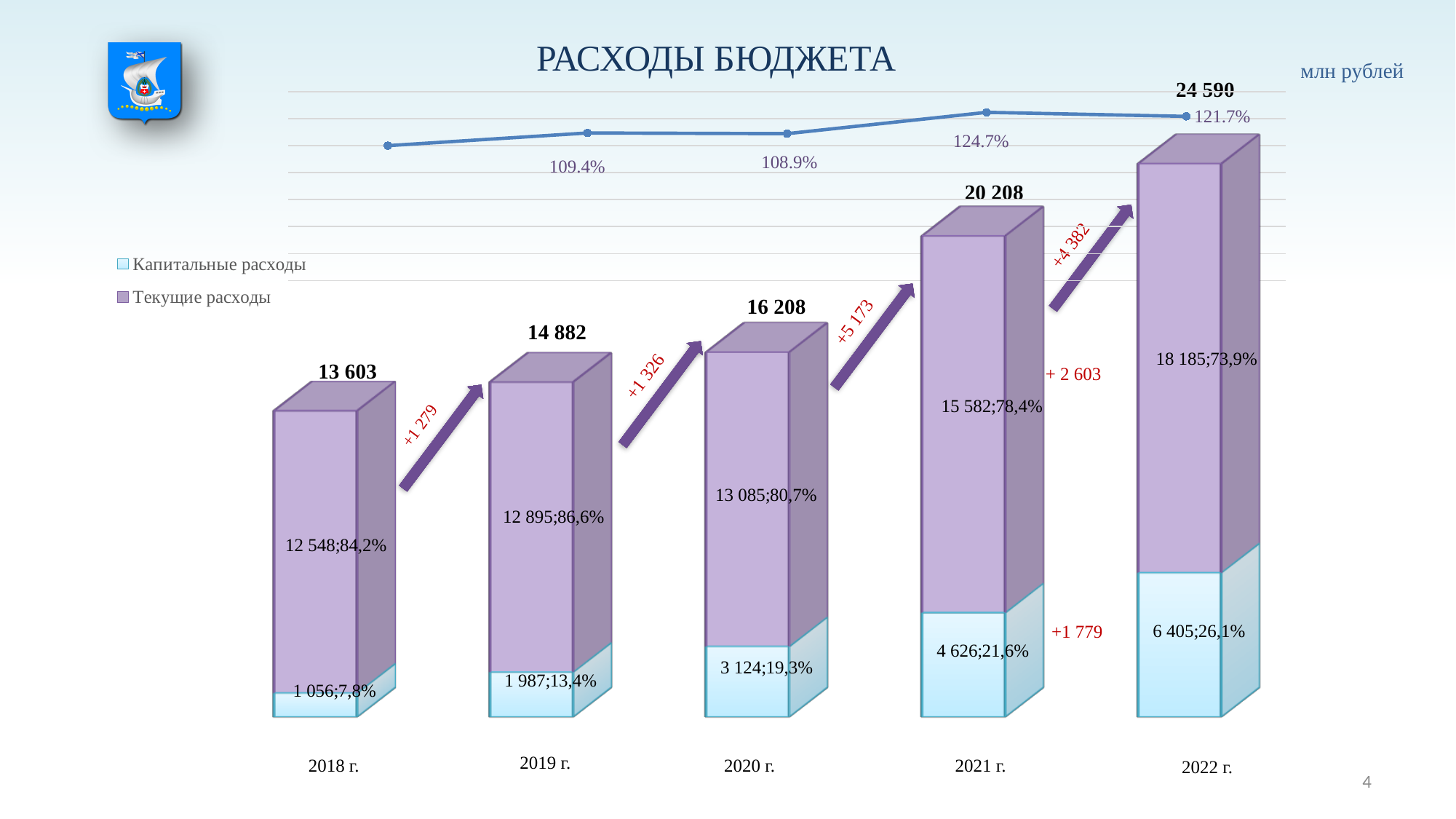
How many series does the legend list? 2 What is the total budget expenditure shown for 2022 г.? 24 590 What is the title of the chart? РАСХОДЫ БЮДЖЕТА How many years (categories) are shown on the x axis? 5 What type of chart is used to show the budget expenditures by year? Stacked bar chart What is the total budget expenditure shown for 2018 г.? 13 603 Which year has the highest total budget expenditure? 2022 г. What is the value of Текущие расходы for 2020 г.? 13 085 What is the value of Капитальные расходы for 2021 г.? 4 626 What is the difference between the total expenditure in 2021 г. and 2020 г.? 4 000 Do the total budget expenditures rise or fall from 2018 г. to 2022 г.? Rise What share of total expenditure do Капитальные расходы make up in 2022 г.? 26,1%